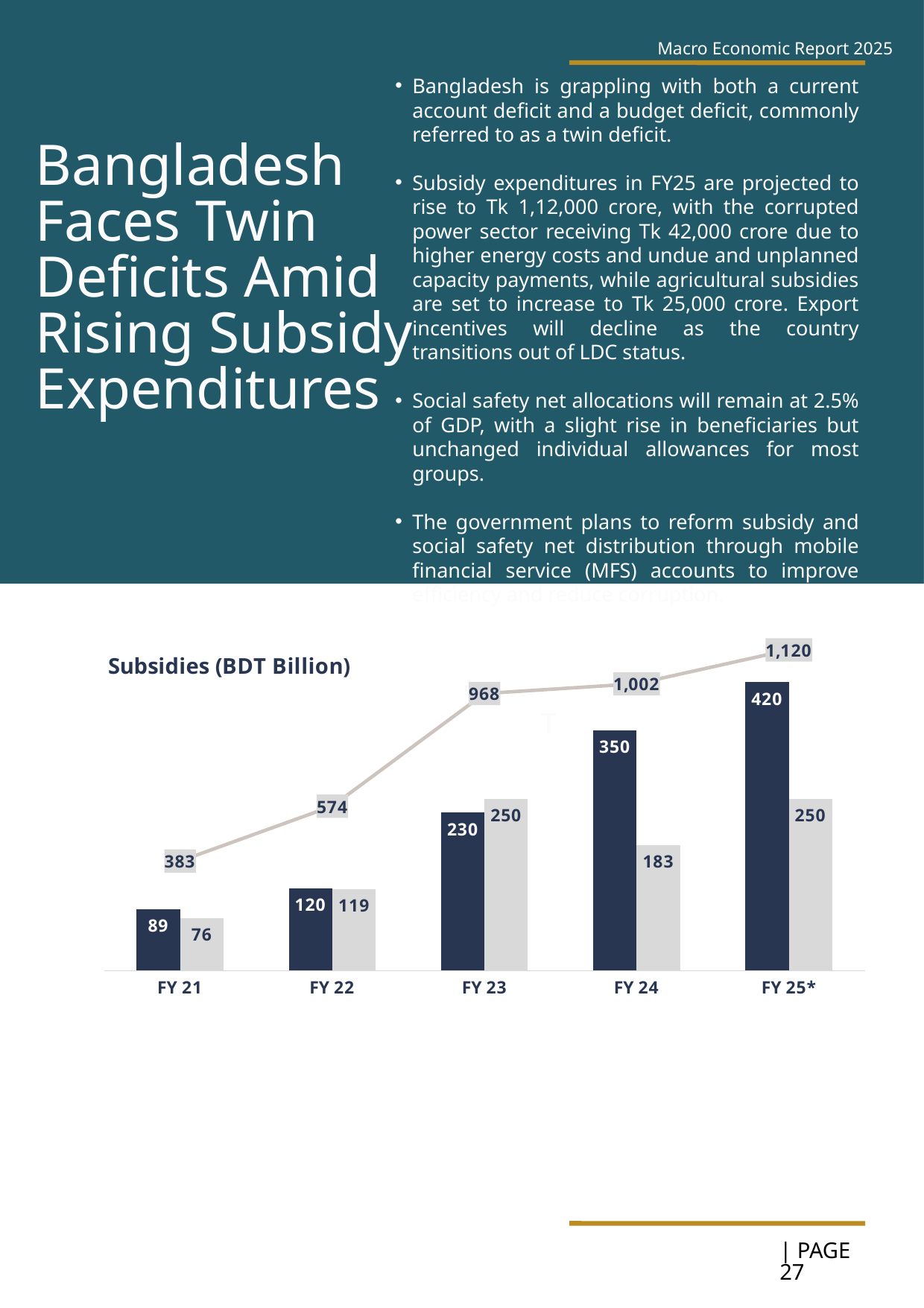
What is the difference between the line values for FY 25* and FY 24? 118 In which fiscal year does the line series reach its highest value? FY 25* What is the difference between the dark blue bar values for FY 25* and FY 24? 70 What is the value of the line series for FY 23? 968 What kind of chart is shown on the slide? a bar chart combined with a line What is the value of the light grey bar for FY 22? 119 In which fiscal year is the light grey bar lowest? FY 21 For FY 23, which is larger: the dark blue bar or the light grey bar? the light grey bar What is the value of the dark blue bar for FY 24? 350 What is the value of the line series for FY 25*? 1,120 How many fiscal years are shown on the x axis? 5 Does the line series rise or fall from FY 21 to FY 25*? rises